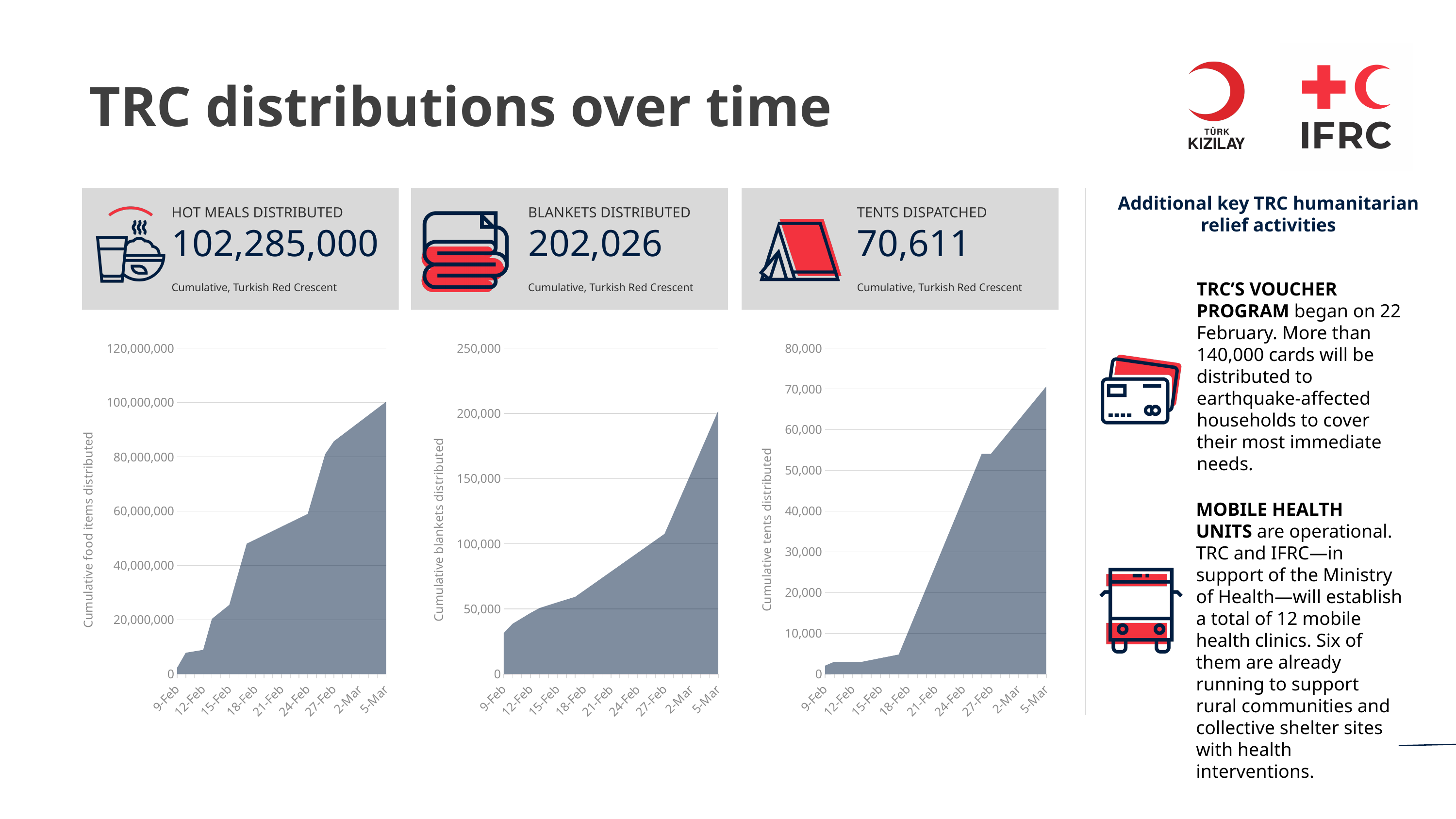
In the right chart (cumulative tents distributed), which date on the x axis has the highest value? 5-Mar In the left chart (cumulative food items distributed), is the value on 12-Feb greater or less than 20,000,000? less In the left chart (cumulative food items distributed), is the value on 18-Feb greater or less than 40,000,000? greater In the left chart (cumulative food items distributed), do the values rise or fall from 9-Feb to 5-Mar? rise In the middle chart (cumulative blankets distributed), is the value on 9-Feb greater or less than 50,000? less What kind of chart is the 'Cumulative food items distributed' chart on the left? area chart What is the highest tick value shown on the y axis of the right chart (cumulative tents distributed)? 80,000 How many date labels are shown on the x axis of the middle chart (cumulative blankets distributed)? 9 What is the y-axis title of the middle chart? Cumulative blankets distributed